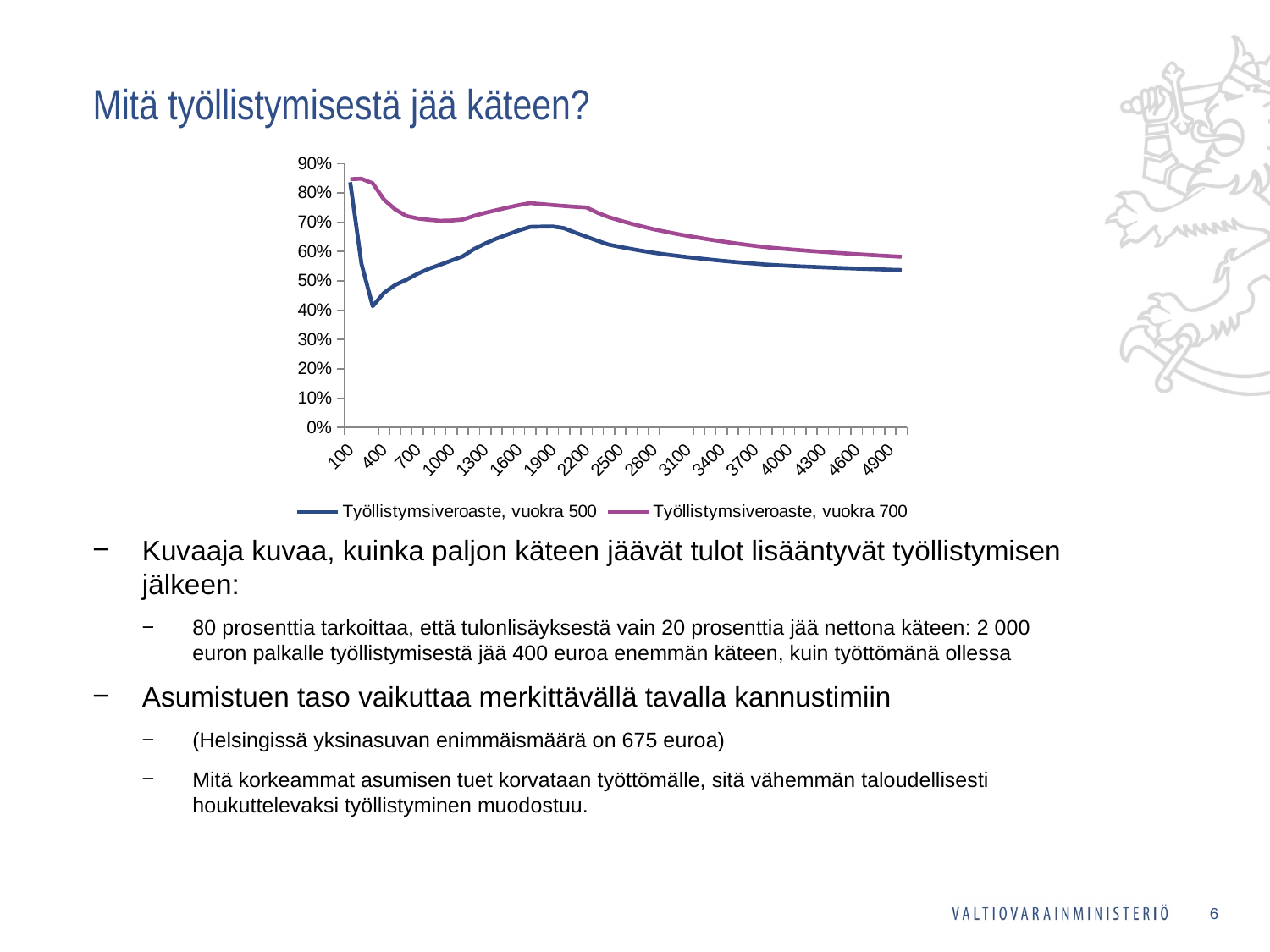
Is the value of 'Työllistymisveroaste, vuokra 700' at 4900 greater or less than 60%? less Do the values of 'Työllistymisveroaste, vuokra 500' rise or fall from 400 to 1900? rise Is the value of 'Työllistymisveroaste, vuokra 700' at 400 greater or less than 80%? less At 4900, which series has the larger value: 'Työllistymisveroaste, vuokra 500' or 'Työllistymisveroaste, vuokra 700'? Työllistymisveroaste, vuokra 700 Is the value of 'Työllistymisveroaste, vuokra 500' at 400 greater or less than 50%? less What colour is the line for 'Työllistymisveroaste, vuokra 700'? purple What kind of chart is shown on the slide? line chart How many series does the legend list? 2 At 400, which series has the larger value: 'Työllistymisveroaste, vuokra 500' or 'Työllistymisveroaste, vuokra 700'? Työllistymisveroaste, vuokra 700 Do the values of 'Työllistymisveroaste, vuokra 700' rise or fall from 2200 to 4900? fall